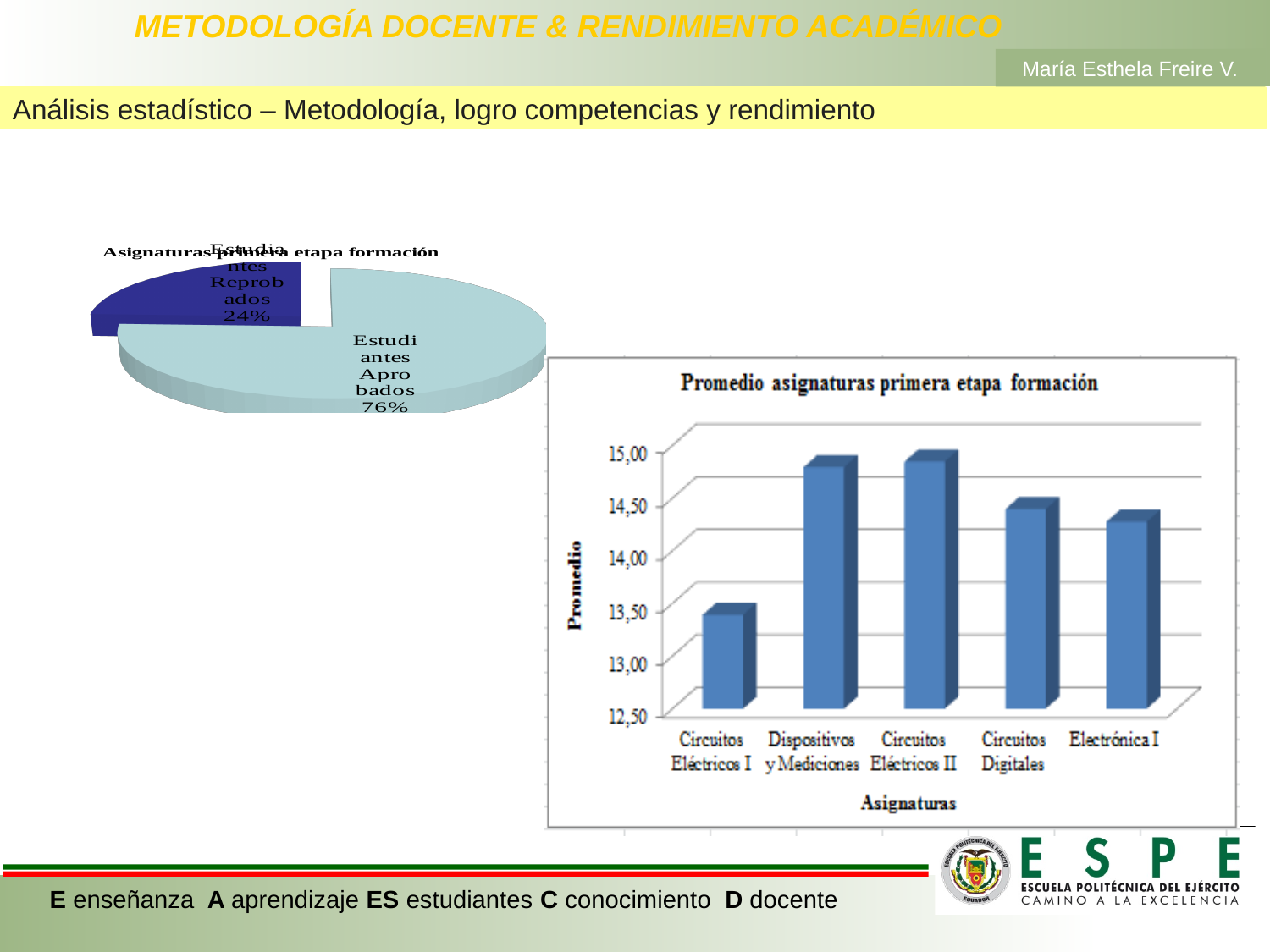
What kind of chart is 'Promedio asignaturas primera etapa formación'? Bar chart In the bar chart 'Promedio asignaturas primera etapa formación', which has the higher average: Dispositivos y Mediciones or Circuitos Digitales? Dispositivos y Mediciones In the bar chart 'Promedio asignaturas primera etapa formación', is the value for Electrónica I greater or less than 14,50? less What kind of chart is the chart on the left of the slide? Pie chart In the pie chart 'Asignaturas primera etapa formación', what percentage of students are Estudiantes Aprobados? 76% How many slices does the pie chart 'Asignaturas primera etapa formación' have? 2 In the pie chart 'Asignaturas primera etapa formación', what percentage of students are Estudiantes Reprobados? 24% How many subjects (asignaturas) are shown in the bar chart 'Promedio asignaturas primera etapa formación'? 5 In the pie chart 'Asignaturas primera etapa formación', which slice is the largest? Estudiantes Aprobados In the bar chart 'Promedio asignaturas primera etapa formación', is the value for Circuitos Eléctricos I greater or less than 14,00? less In the bar chart 'Promedio asignaturas primera etapa formación', is the value for Dispositivos y Mediciones greater or less than 14,50? greater In the bar chart 'Promedio asignaturas primera etapa formación', which subject has the lowest average? Circuitos Eléctricos I